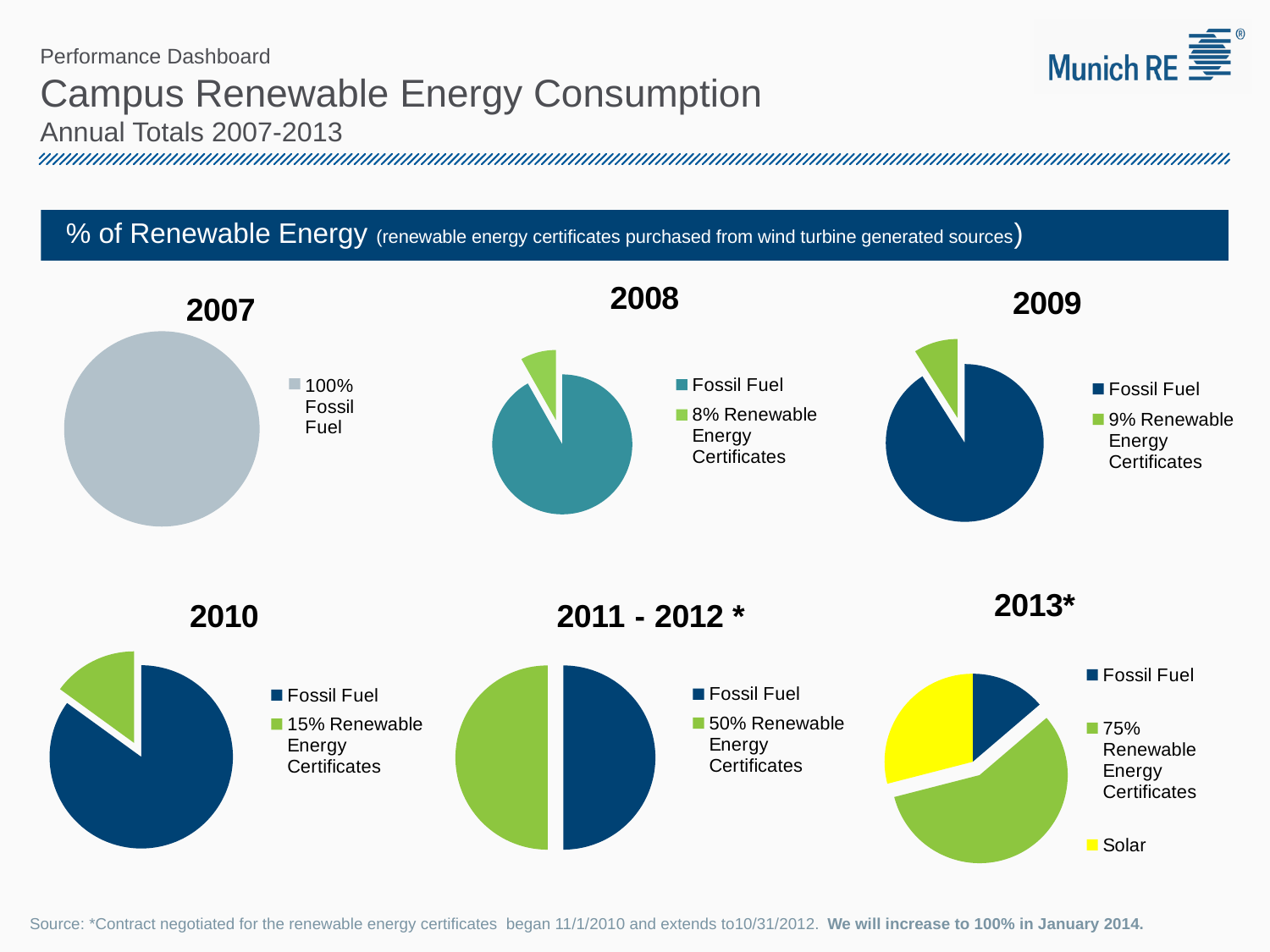
In the 2013* pie chart, what percentage is Renewable Energy Certificates? 75% Which legend entry in the 2013* pie chart is shown in yellow? Solar In the 2011 - 2012 * pie chart, what percentage is Renewable Energy Certificates? 50% In the 2010 pie chart, what percentage is Renewable Energy Certificates? 15% How many pie charts are on the slide? 6 How many entries does the legend of the 2013* pie chart list? 3 In the 2009 pie chart, what percentage is Renewable Energy Certificates? 9% In the 2007 pie chart, what percentage is Fossil Fuel? 100% What kind of charts are shown on the slide? Pie charts In the 2008 pie chart, what percentage is Renewable Energy Certificates? 8% Which year's pie chart has the larger Renewable Energy Certificates share, 2009 or 2010? 2010 What is the difference in the Renewable Energy Certificates percentage between the 2010 and 2009 pie charts? 6%